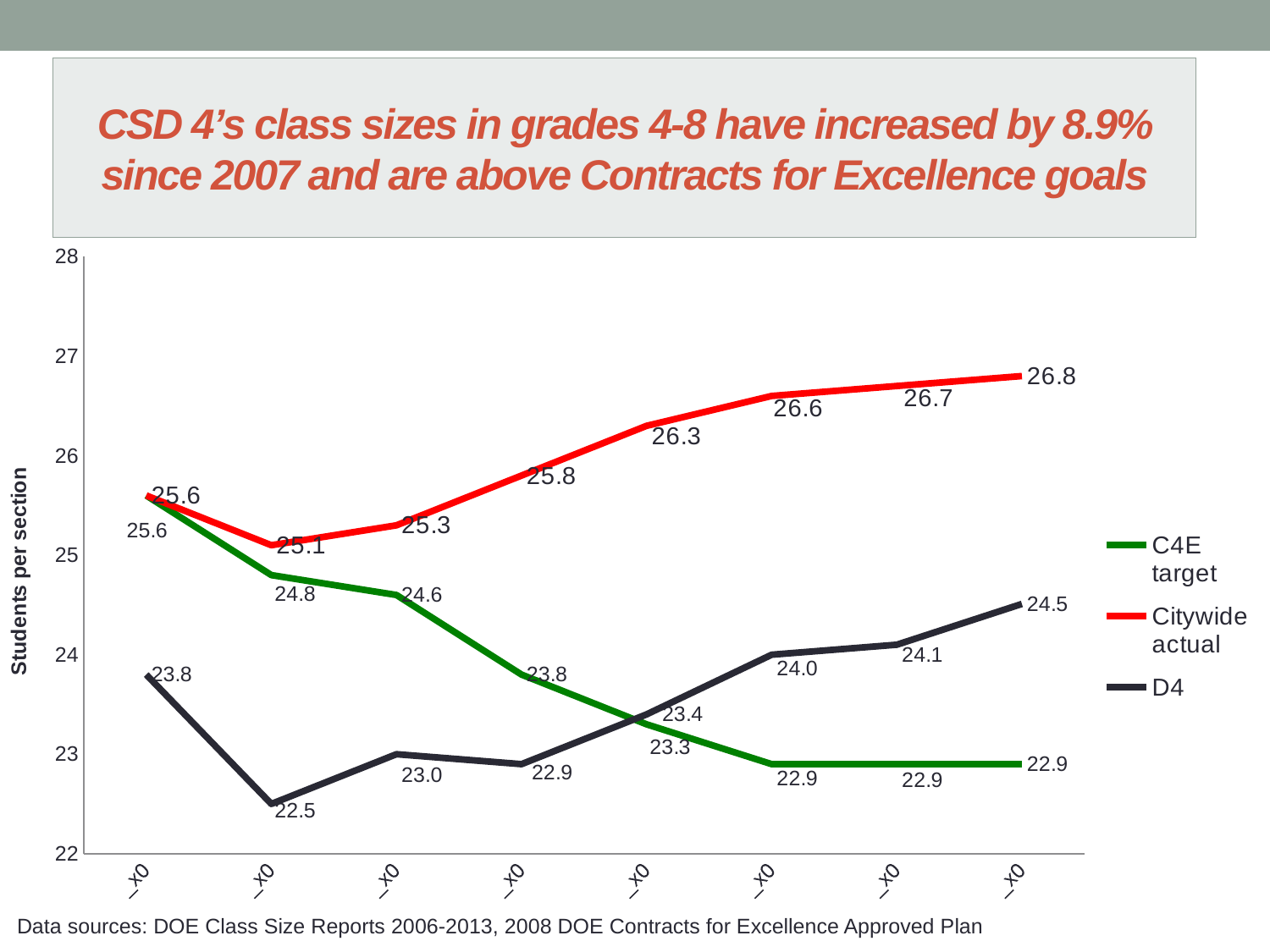
What is the final (rightmost) value of the Citywide actual line? 26.8 What is the final (rightmost) value of the D4 line? 24.5 Does the C4E target line rise or fall from left to right? fall At the rightmost point, which is larger: the D4 value or the C4E target value? D4 What kind of chart is shown on the slide? line chart What is the difference between the last value of the Citywide actual line (26.8) and the last value of the C4E target line (22.9)? 3.9 What is the lowest value on the D4 line? 22.5 What is the highest value on the Citywide actual line? 26.8 What is the label on the vertical axis? Students per section Does the Citywide actual line generally rise or fall from its second point to its last point? rise How many series does the legend list? 3 How many data points does each line have? 8